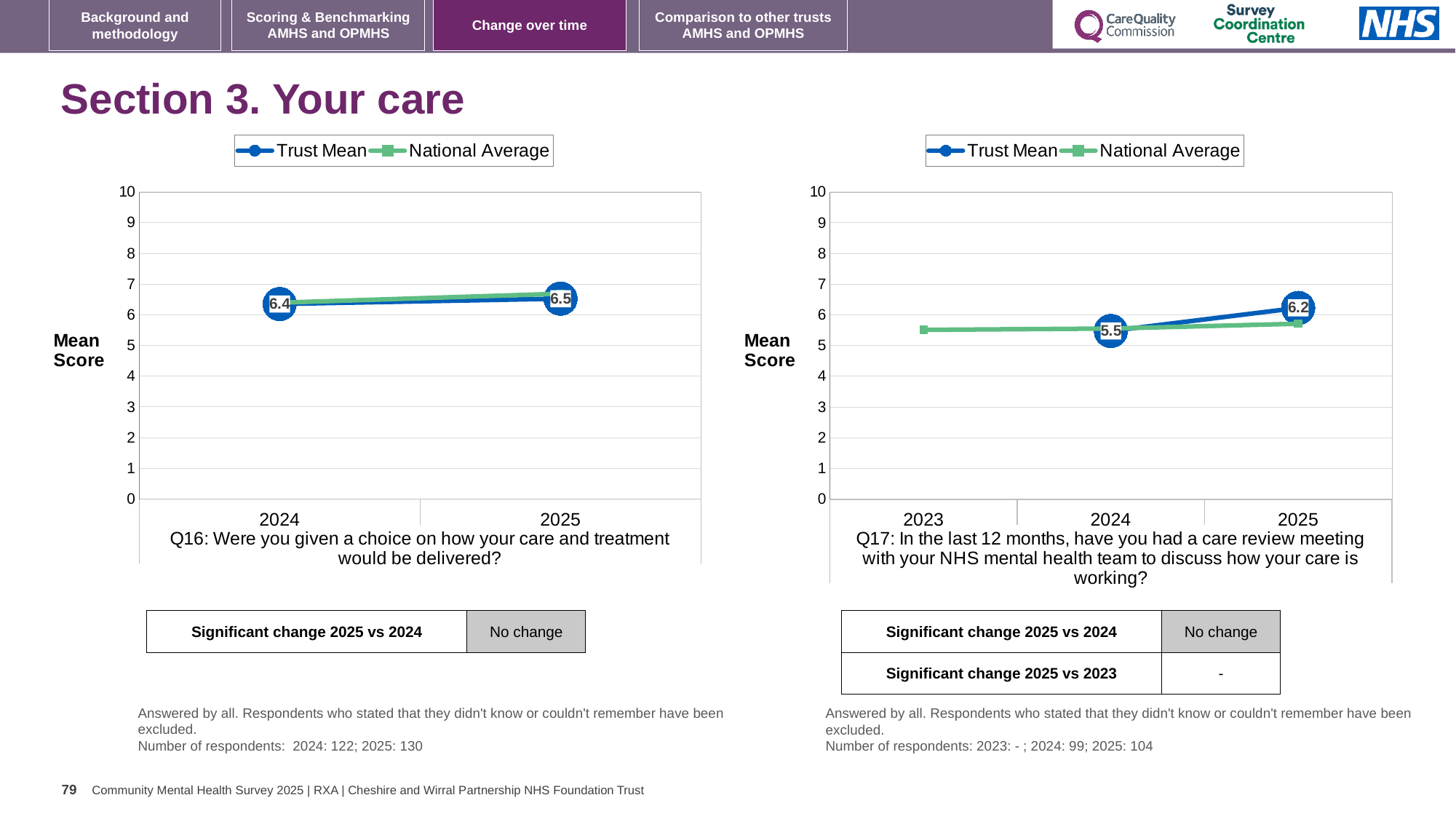
In the Q16 chart on the left, what is the Trust Mean for 2025? 6.5 What kind of chart is the Q16 chart on the left? Line chart How many years are shown on the x axis of the Q17 chart on the right? 3 In the Q17 chart on the right, what is the Trust Mean for 2024? 5.5 In the Q16 chart on the left, what is the difference between the Trust Mean for 2025 and 2024? 0.1 In the Q17 chart on the right, by how much did the Trust Mean change from 2024 to 2025? 0.7 In the Q17 chart on the right, what is the Trust Mean for 2025? 6.2 In the Q17 chart on the right, is the National Average for 2023 greater or less than 6? less In the Q17 chart on the right, which year has the higher Trust Mean, 2024 or 2025? 2025 In the Q17 chart on the right, does the Trust Mean rise or fall from 2024 to 2025? Rise How many series does the legend of the Q16 chart on the left list? 2 In the Q16 chart on the left, what is the Trust Mean for 2024? 6.4